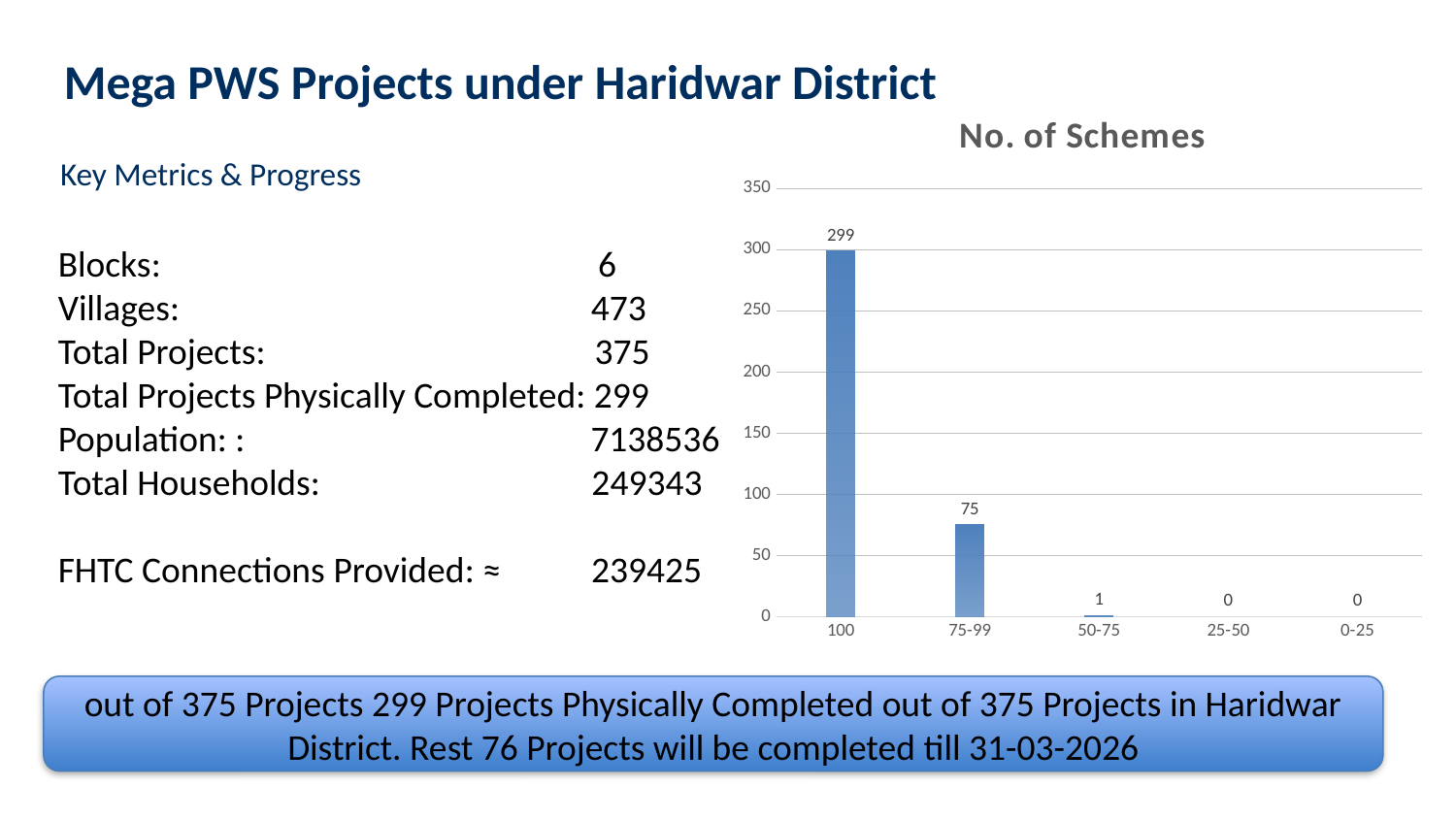
How many categories are shown on the x axis of the No. of Schemes chart? 5 What is the value for the 75-99 category in the No. of Schemes chart? 75 Do the values in the No. of Schemes chart rise or fall from left to right along the x axis? fall What kind of chart is the No. of Schemes chart? bar chart Which category has the highest value in the No. of Schemes chart? 100 Which is larger in the No. of Schemes chart, the value for 75-99 or the value for 50-75? 75-99 Is the value for the 100 category in the No. of Schemes chart greater or less than 250? greater What is the value for the 25-50 category in the No. of Schemes chart? 0 What is the difference between the values for the 100 and 75-99 categories in the No. of Schemes chart? 224 What is the value for the 100 category in the No. of Schemes chart? 299 What is the title of the chart on the slide? No. of Schemes What is the value for the 50-75 category in the No. of Schemes chart? 1